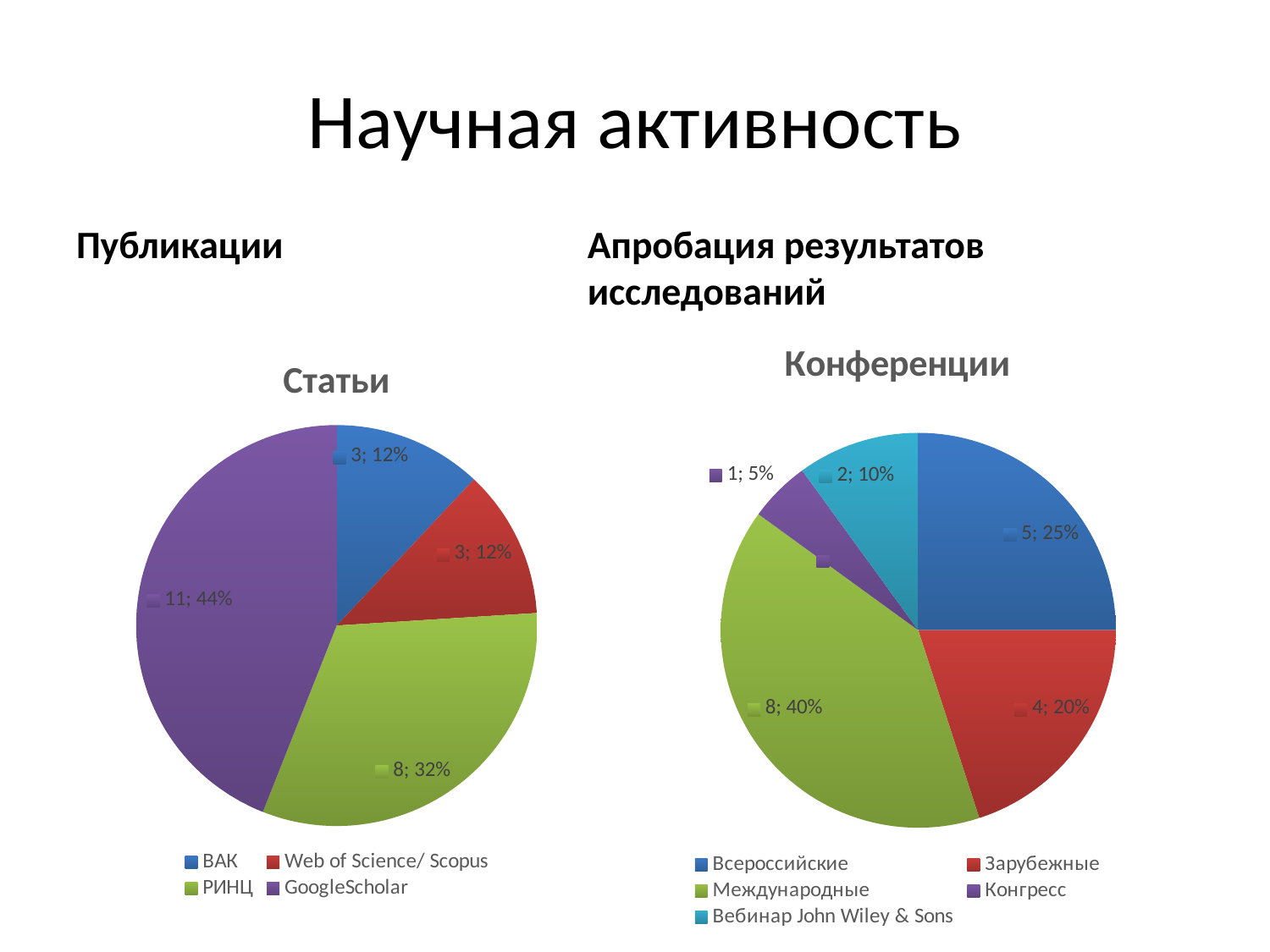
In the "Конференции" chart, which is larger: Зарубежные or Вебинар John Wiley & Sons? Зарубежные In the "Конференции" chart, what is the difference between the Международные count and the Зарубежные count? 4 In the "Конференции" chart, what value is shown for Международные? 8; 40% In the "Статьи" chart, what value is shown for GoogleScholar? 11; 44% In the "Конференции" chart, what share of the pie does Всероссийские have? 25% In the "Конференции" chart, which category has the smallest slice? Конгресс In the "Статьи" chart, which category has the largest slice? GoogleScholar In the "Статьи" chart, how many categories does the legend list? 4 What kind of chart is the "Статьи" chart? pie chart In the "Статьи" chart, what share of the pie does РИНЦ have? 32% How many categories does the legend of the "Конференции" chart list? 5 In the "Статьи" chart, what is the difference between the GoogleScholar count and the РИНЦ count? 3